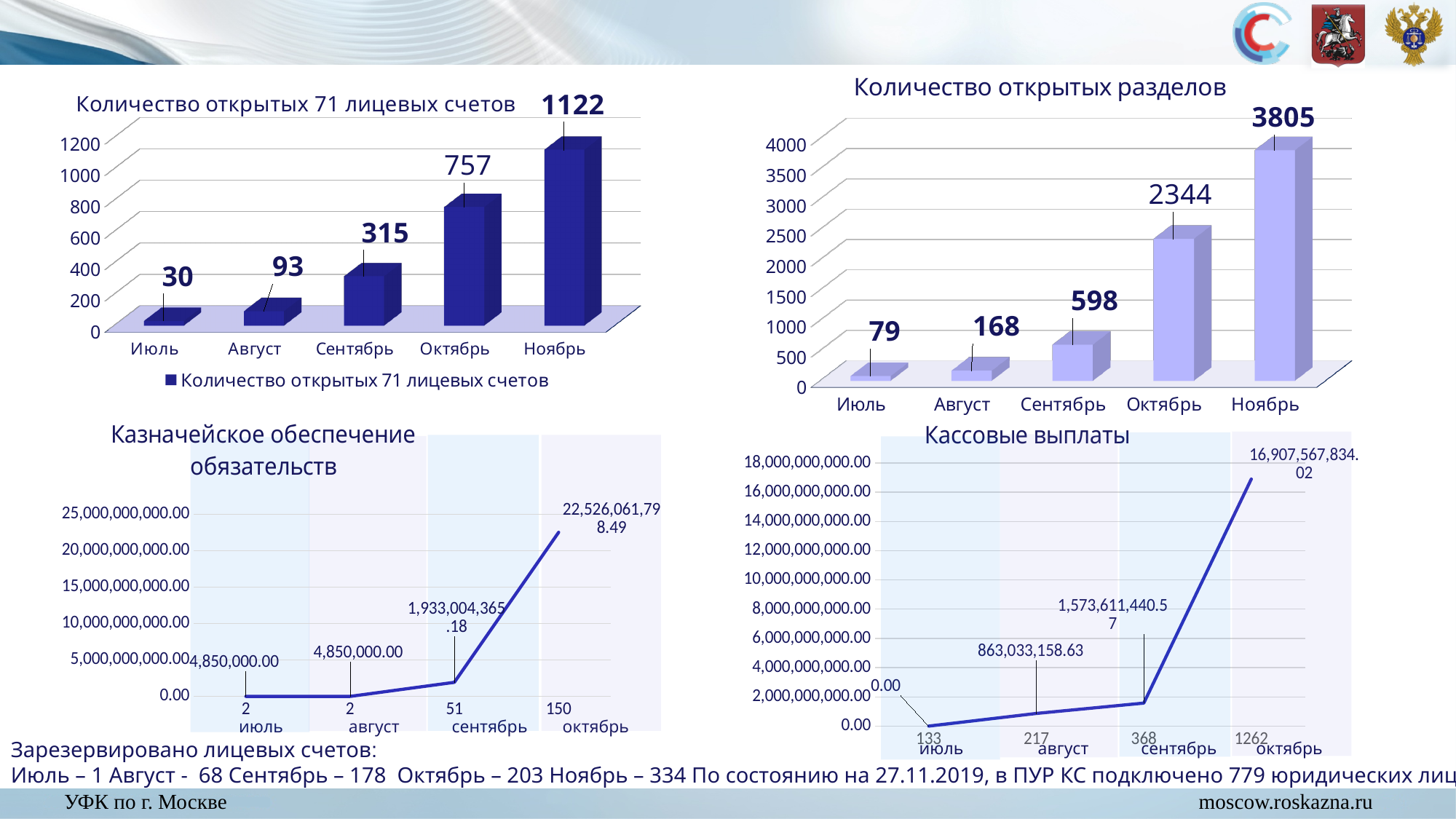
In the chart titled "Количество открытых разделов", how many months are shown on the x axis? 5 In the chart titled "Количество открытых разделов", which month has the highest value? Ноябрь In the chart titled "Количество открытых разделов", is the value for Сентябрь greater or less than Август? greater What kind of chart is the one titled "Количество открытых 71 лицевых счетов"? bar chart In the chart titled "Казначейское обеспечение обязательств", what is the value for сентябрь? 1,933,004,365.18 In the chart titled "Количество открытых 71 лицевых счетов", what is the difference between the values for Октябрь and Сентябрь? 442 In the chart titled "Количество открытых 71 лицевых счетов", which month has the lowest value? Июль What kind of chart is the one titled "Казначейское обеспечение обязательств"? line chart In the chart titled "Кассовые выплаты", do the values rise or fall from июль to октябрь? rise In the chart titled "Количество открытых разделов", what is the value for Октябрь? 2344 In the chart titled "Кассовые выплаты", what is the value for октябрь? 16,907,567,834.02 In the chart titled "Количество открытых 71 лицевых счетов", what is the value for Ноябрь? 1122